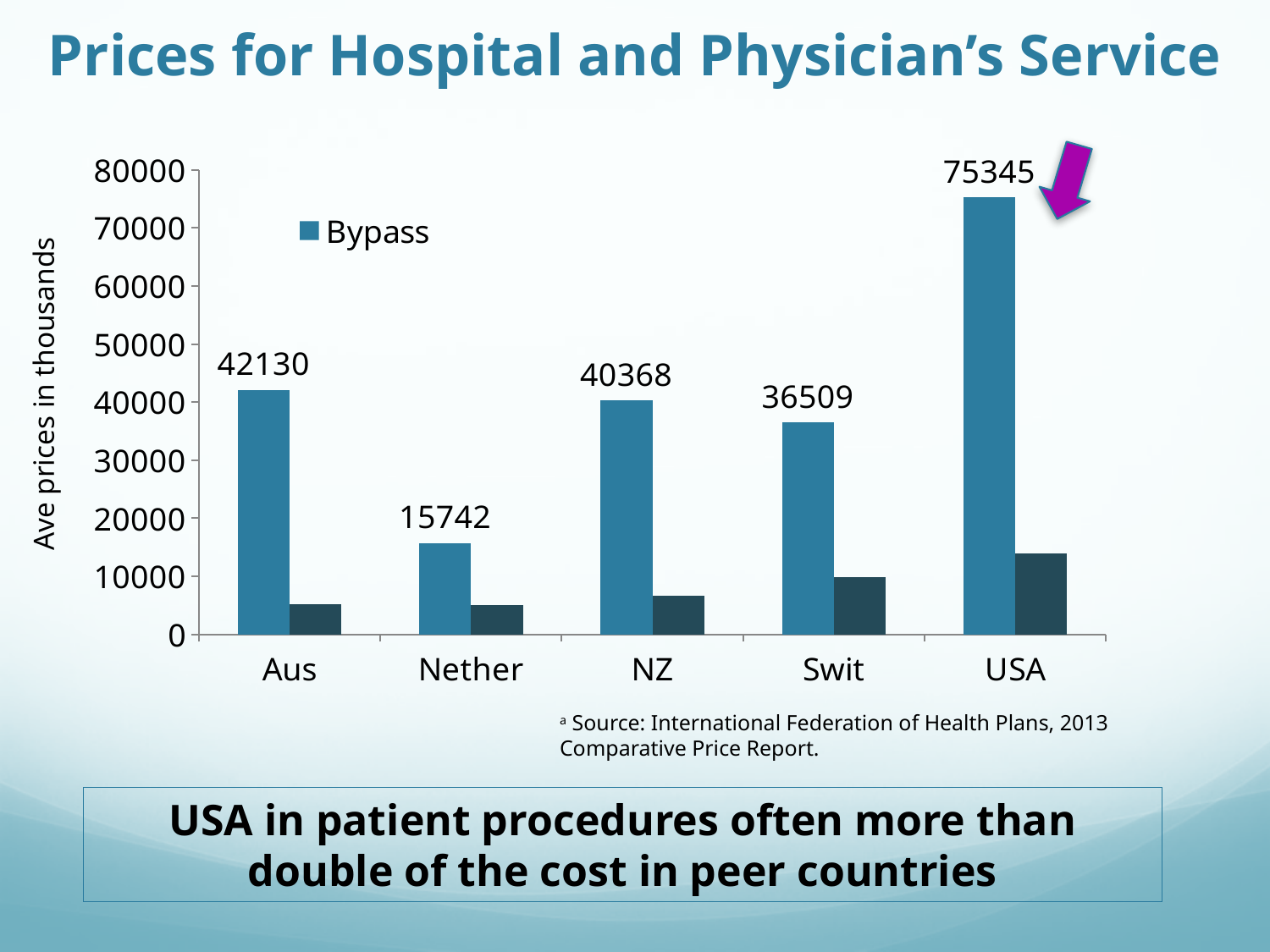
Which country has the highest Bypass value? USA What kind of chart is shown on the slide? bar chart How many series does the legend list? 1 Which has a larger Bypass value, NZ or Swit? NZ What is the difference between the Bypass values for USA and Aus? 33215 Which country has the lowest Bypass value? Nether Is the value of the dark bar for USA greater or less than 20000? less What is the Bypass value for Aus? 42130 What is the title of the vertical axis? Ave prices in thousands What is the Bypass value for USA? 75345 What is the Bypass value for Nether? 15742 How many countries are shown on the x axis? 5